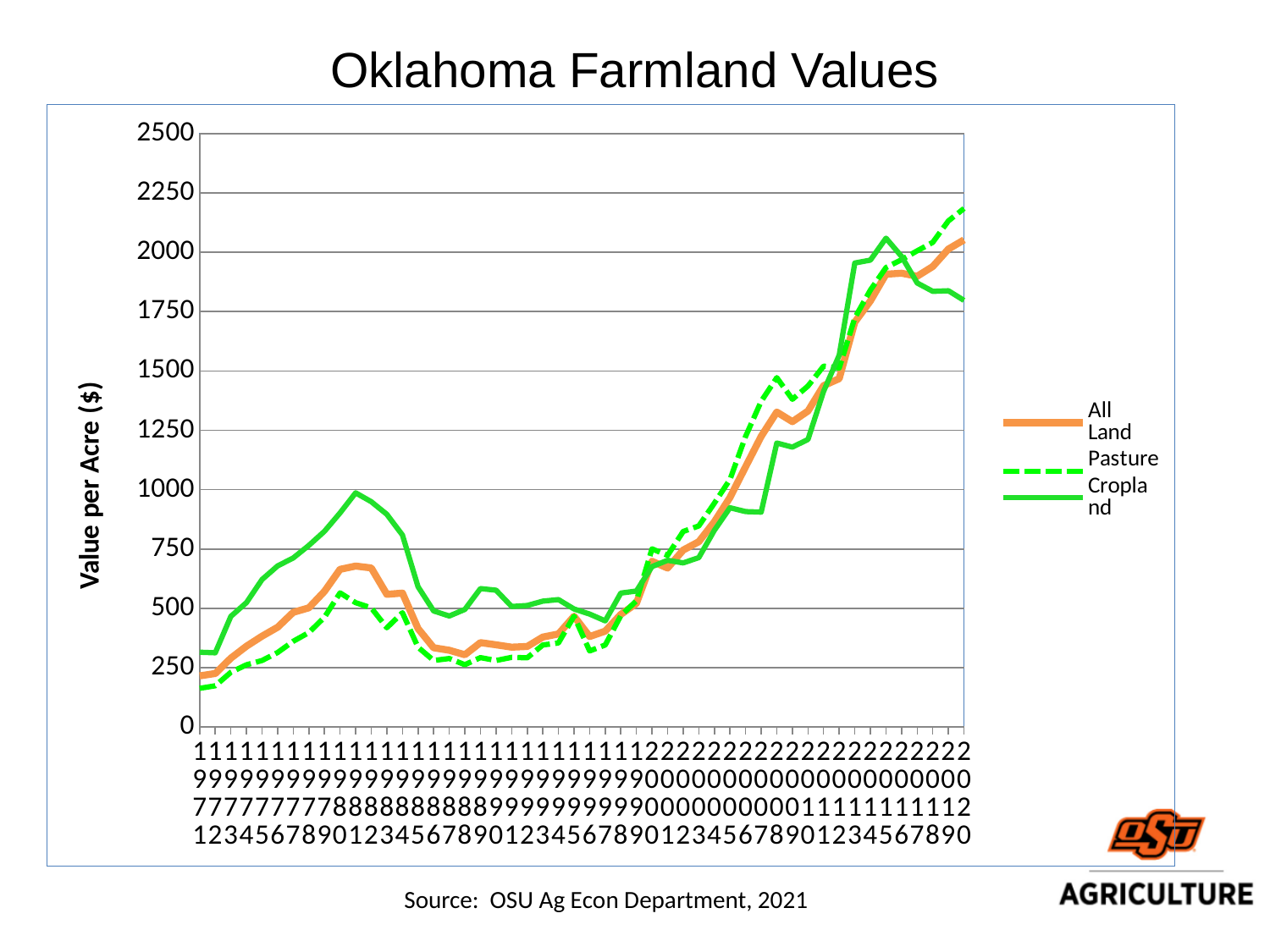
What kind of chart is shown on the slide? line chart In 1981, which series has the higher value, Cropland or Pasture? Cropland Is the All Land value in 1971 greater or less than 250? less Is the Cropland value in 2020 greater or less than 2000? less In 2020, which series has the higher value, Pasture or Cropland? Pasture Which series is drawn with a dashed line? Pasture How many series does the legend list? 3 Is the Cropland value in 1981 greater or less than 750? greater What is the title of the chart? Oklahoma Farmland Values Overall, do the All Land values rise or fall from 1971 to 2020? rise